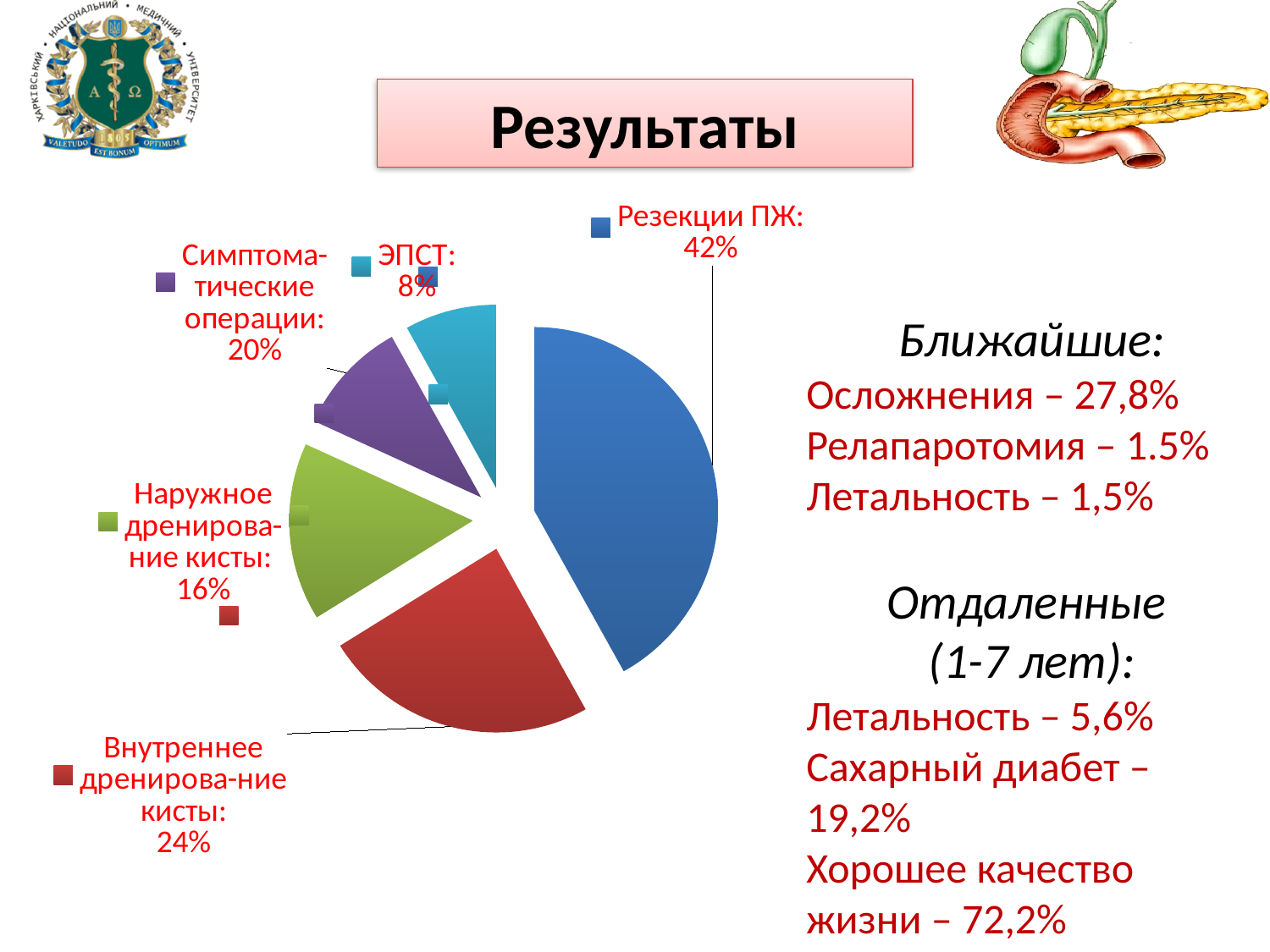
What percentage is shown for ЭПСТ in the pie chart? 8% What percentage is shown for Внутреннее дренирование кисты in the pie chart? 24% What colour is the slice for Резекции ПЖ? Blue Which category has the smallest slice in the pie chart? ЭПСТ How many slices does the pie chart have? 5 What percentage is shown for Симптоматические операции in the pie chart? 20% What is the difference in percentage points between Резекции ПЖ and Внутреннее дренирование кисты? 18 What type of chart is shown on the slide? Pie chart What percentage is shown for Наружное дренирование кисты in the pie chart? 16% Which category has the largest slice in the pie chart? Резекции ПЖ What percentage is shown for Резекции ПЖ in the pie chart? 42%